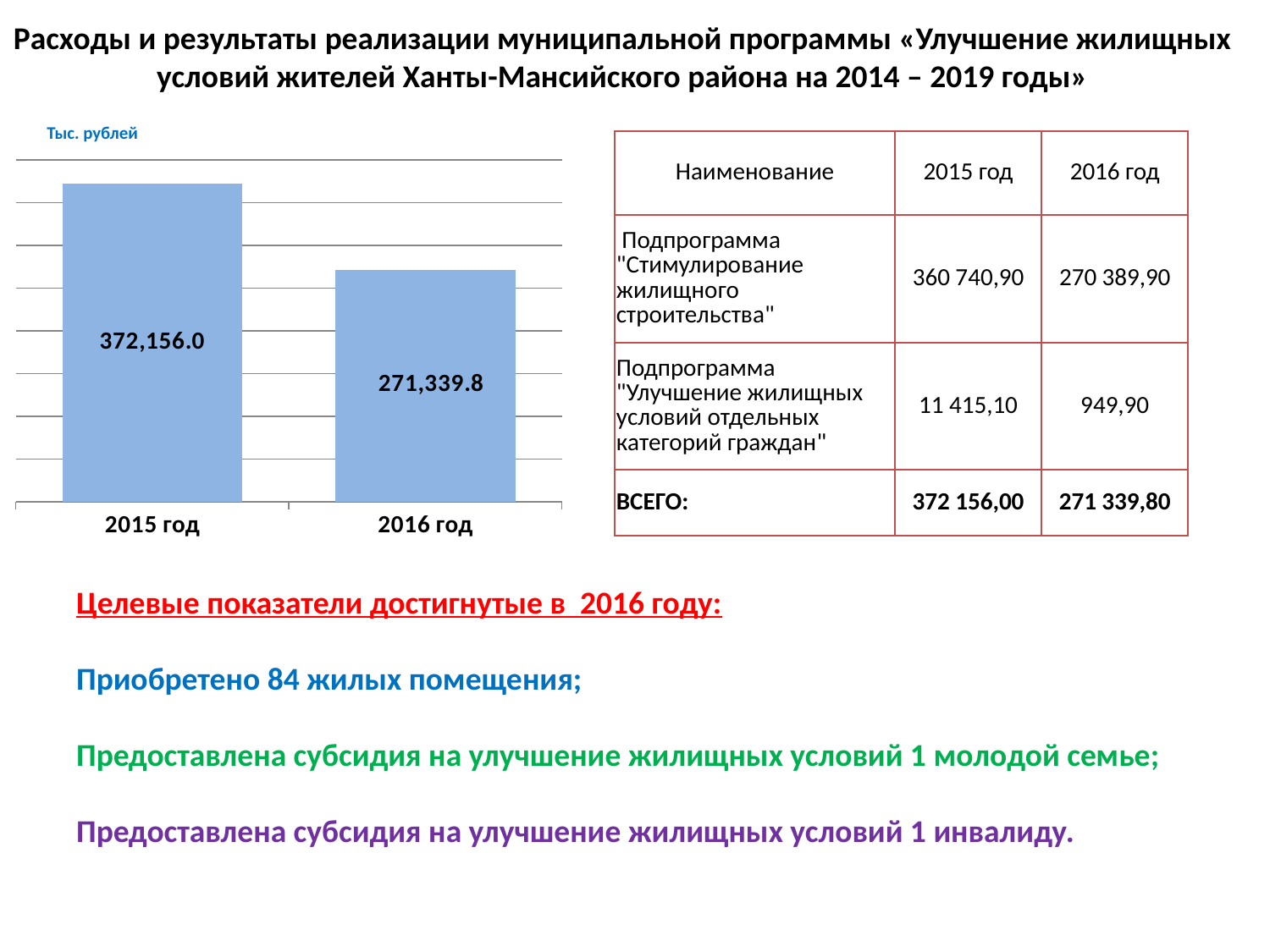
How many bars are shown in the bar chart? 2 What is the difference between the values for 2015 год and 2016 год in the bar chart? 100,816.2 What colour are the bars in the bar chart? blue Which year has the highest value in the bar chart? 2015 год What is the value for 2016 год in the bar chart? 271,339.8 Which year has the lowest value in the bar chart? 2016 год What unit is indicated above the bar chart? Тыс. рублей Do the values in the bar chart rise or fall from 2015 год to 2016 год? fall What is the value for 2015 год in the bar chart? 372,156.0 What type of chart is shown on the slide? bar chart Which is larger in the bar chart: the value for 2015 год or for 2016 год? 2015 год